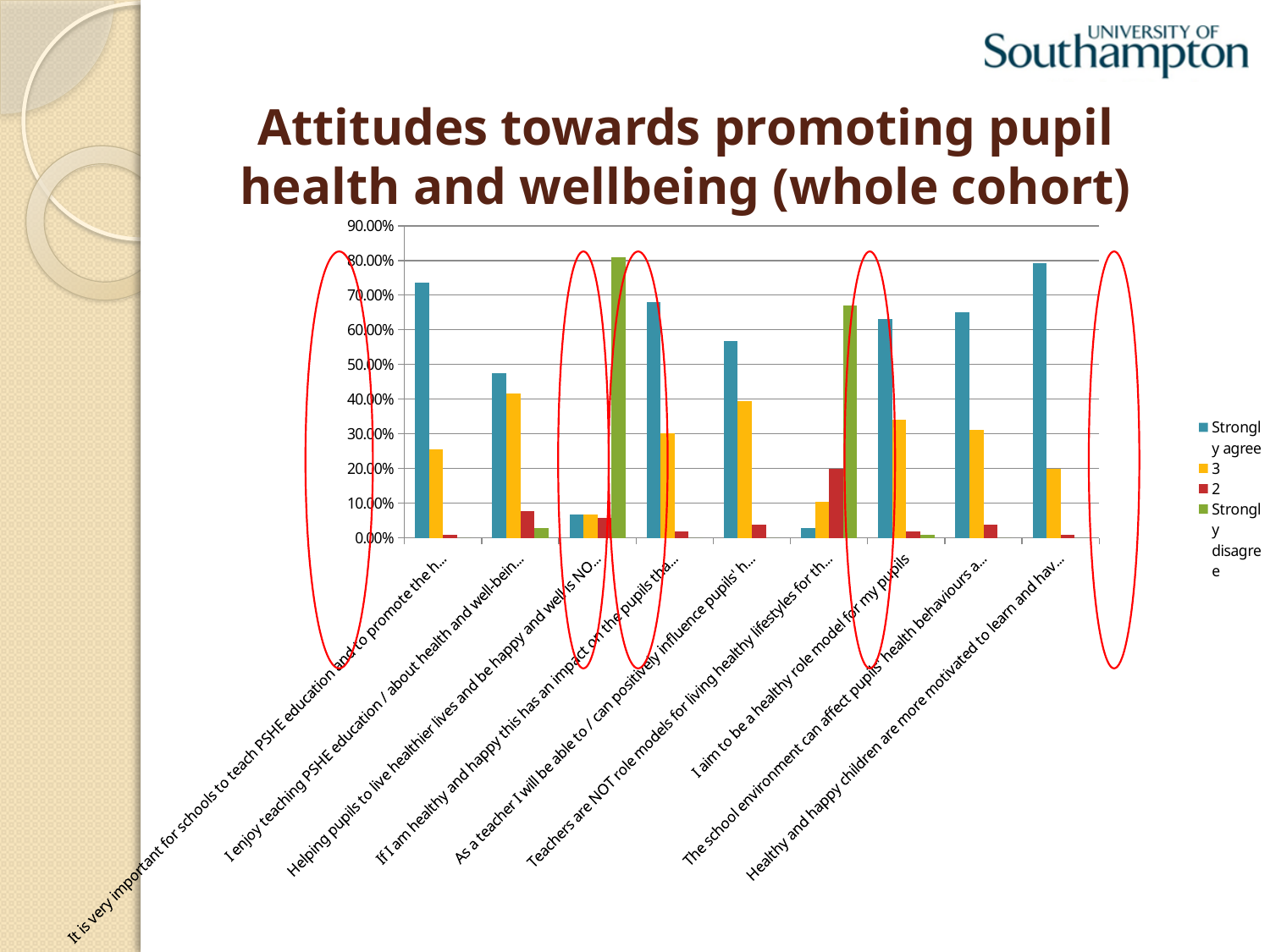
Is the 'Strongly agree' value for 'I aim to be a healthy role model for my pupils' greater or less than 50.00%? greater What are the four entries in the chart legend? Strongly agree, 3, 2, Strongly disagree What is the title of the slide? Attitudes towards promoting pupil health and wellbeing (whole cohort) Which has the larger '2' value: 'Teachers are NOT role models for living healthy lifestyles for th...' or 'I enjoy teaching PSHE education / about health and well-bein...'? Teachers are NOT role models for living healthy lifestyles for th... Is the '3' value for 'It is very important for schools to teach PSHE education and to promote the h...' greater or less than 30.00%? less What kind of chart is shown on the slide? Bar chart Is the 'Strongly agree' value for 'Helping pupils to live healthier lives and be happy and well is NO...' greater or less than 10.00%? less For 'I enjoy teaching PSHE education / about health and well-bein...', which is larger: the 'Strongly agree' bar or the '3' bar? Strongly agree How many statement categories are plotted along the x axis? 9 How many series does the legend list? 4 Which statement has the highest 'Strongly agree' value? Healthy and happy children are more motivated to learn and hav...